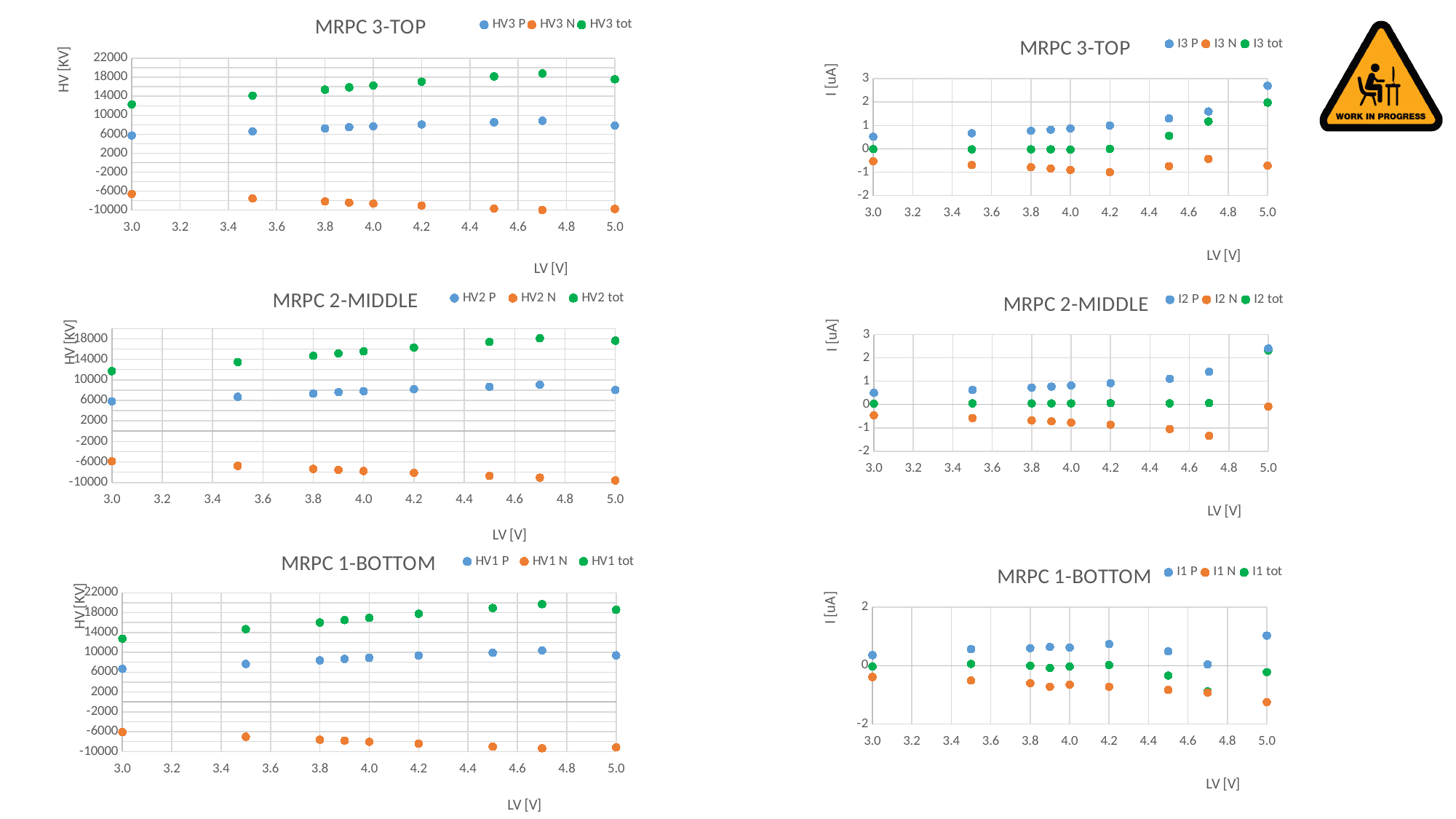
In the top-right chart (MRPC 3-TOP, I [uA]), how many LV points are plotted for the I3 P series? 9 In the top-right chart (MRPC 3-TOP, I [uA]), is the I3 P value at LV 5.0 greater or less than 2? greater In the top-right chart (MRPC 3-TOP, I [uA]), at which LV value is I3 P highest? 5.0 In the top-left chart (MRPC 3-TOP, HV [KV]), at which LV value is HV3 tot highest? 4.7 What kind of chart is the top-left chart titled MRPC 3-TOP? scatter chart In the top-left chart (MRPC 3-TOP, HV [KV]), is the HV3 tot value at LV 5.0 greater or less than 14000? greater How many series does the legend of the bottom-left chart (MRPC 1-BOTTOM, HV) list? 3 What is the y-axis label of the three charts in the right column? I [uA] In the bottom-left chart (MRPC 1-BOTTOM, HV [KV]), is the HV1 tot value at LV 4.7 greater or less than 18000? greater In the top-right chart (MRPC 3-TOP, I [uA]), does the I3 P series rise or fall as LV increases from 3.0 to 5.0? rise